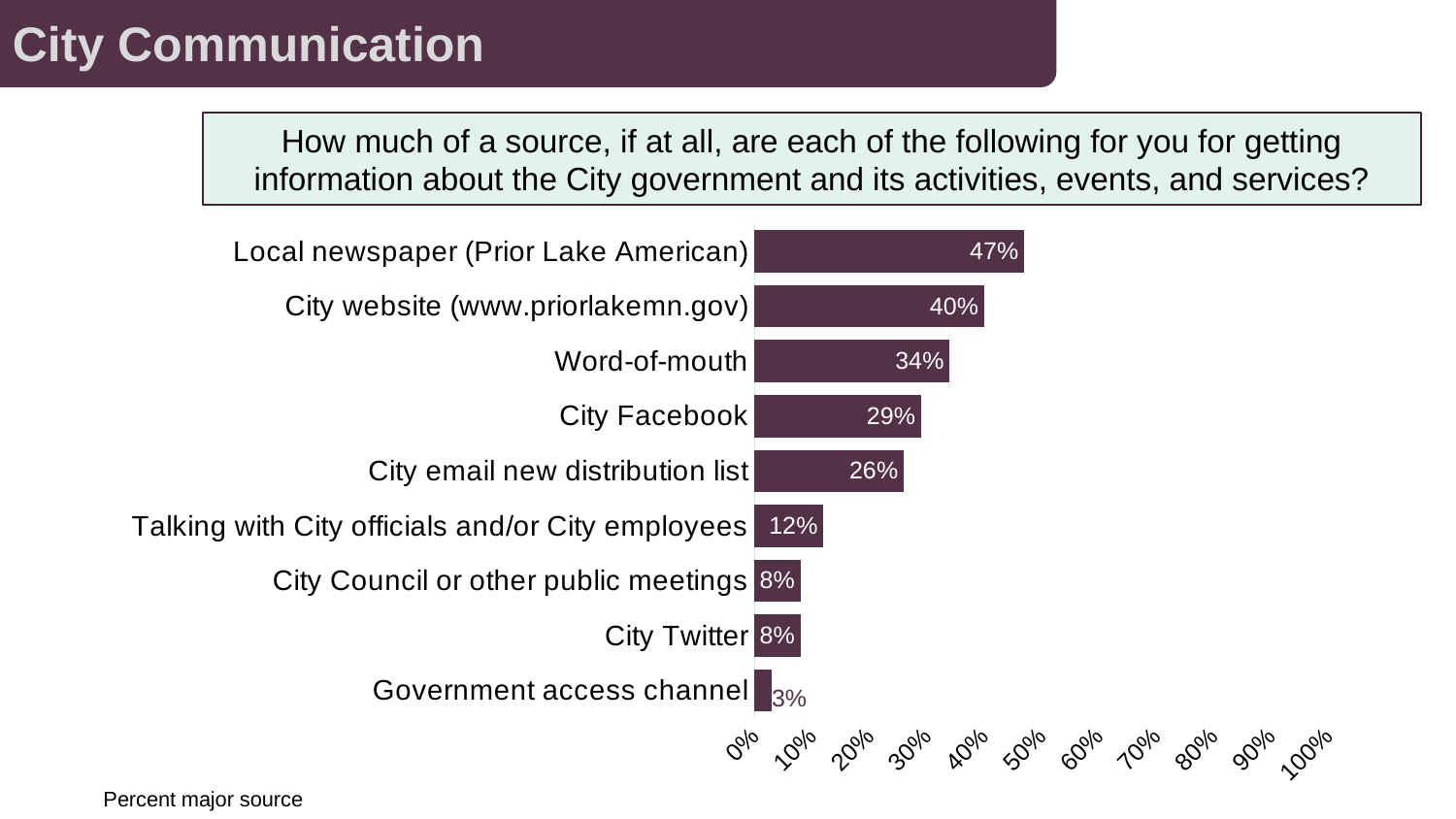
What is the difference between the values for the City website and Word-of-mouth? 6% What is the value for Talking with City officials and/or City employees? 12% Which source has the highest percentage? Local newspaper (Prior Lake American) What does the note below the chart say the values represent? Percent major source Which source has the lowest percentage? Government access channel How many sources are shown in the chart? 9 What percentage of respondents cite the local newspaper (Prior Lake American) as a major source? 47% Which is larger, the value for City Facebook or the value for Word-of-mouth? Word-of-mouth Is the value for the local newspaper greater or less than 50%? less What is the value for the City email new distribution list? 26% What kind of chart is shown on the slide? Bar chart What is the value for City Facebook? 29%